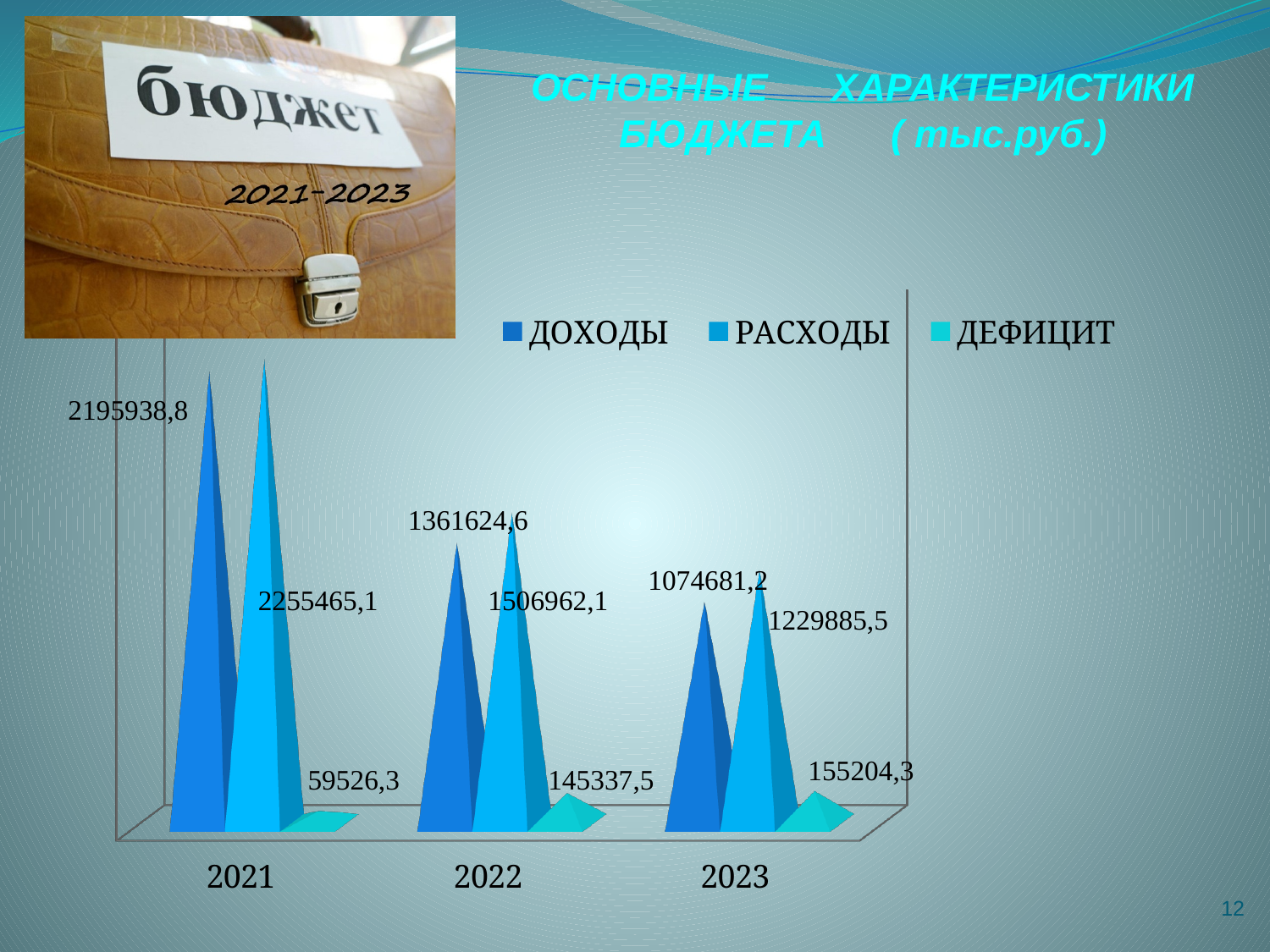
In which year is ДЕФИЦИТ the lowest? 2021 What is the difference between РАСХОДЫ and ДОХОДЫ in 2022? 145337,5 What is the value of ДОХОДЫ for 2023? 1074681,2 Which is larger in 2023, ДОХОДЫ or РАСХОДЫ? РАСХОДЫ What is the value of ДЕФИЦИТ for 2023? 155204,3 What kind of chart is shown on the slide? bar chart How many years are shown on the x axis? 3 In which year is ДОХОДЫ the highest? 2021 What is the value of ДОХОДЫ for 2021? 2195938,8 What is the value of РАСХОДЫ for 2022? 1506962,1 How many series does the legend list? 3 Do the ДОХОДЫ values rise or fall from 2021 to 2023? fall